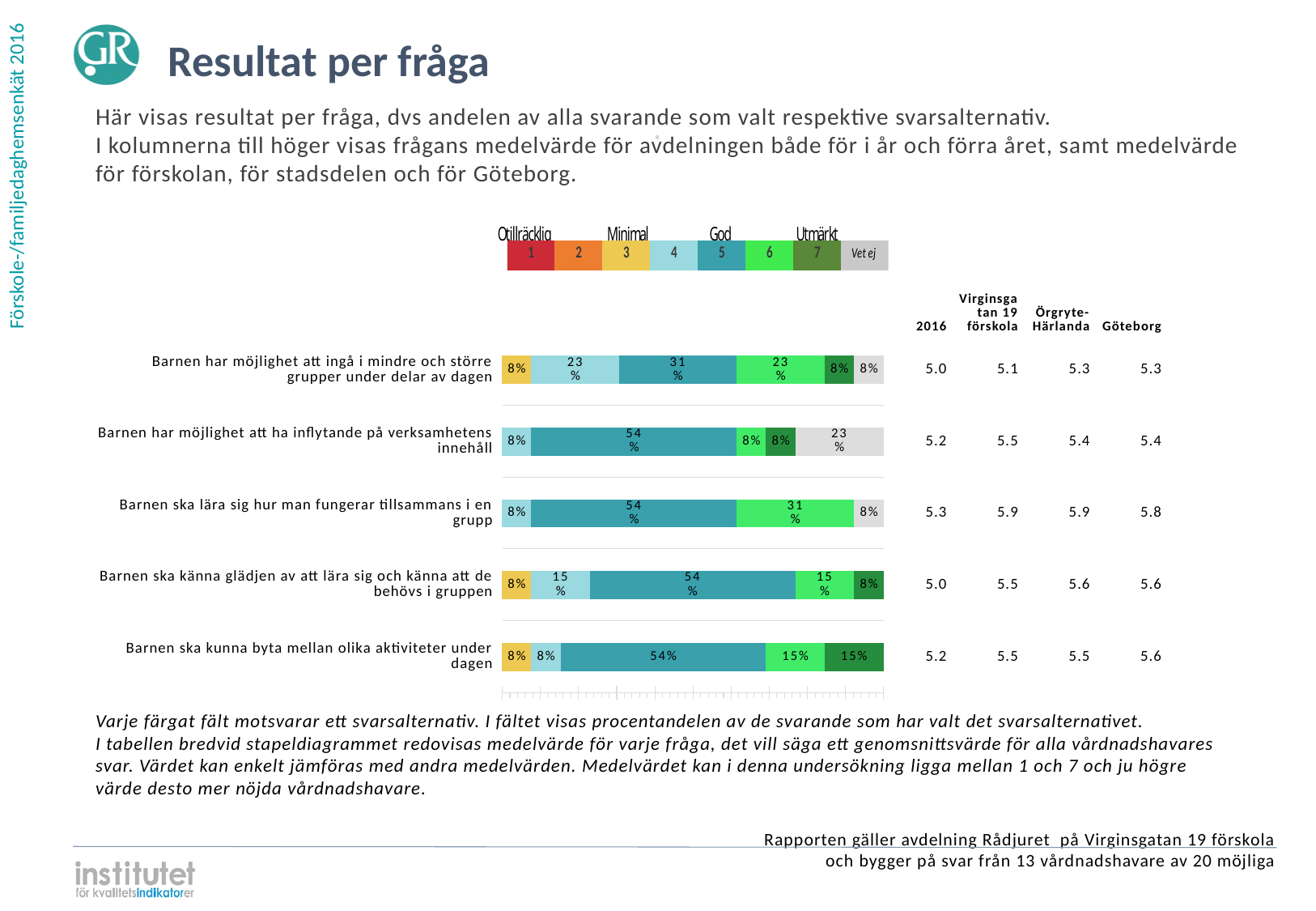
What kind of chart is shown on the slide? Stacked bar chart Which question has the highest 2016 mean value? Barnen ska lära sig hur man fungerar tillsammans i en grupp What percentage chose 'Vet ej' for 'Barnen har möjlighet att ha inflytande på verksamhetens innehåll'? 23% For 'Barnen ska kunna byta mellan olika aktiviteter under dagen', which is larger: the share for answer 5 or the share for answer 7? Answer 5 What percentage of respondents chose answer 5 (teal) for 'Barnen ska kunna byta mellan olika aktiviteter under dagen'? 54% How many answer categories does the legend above the chart list? 8 How many questions (bars) are shown in the chart? 5 What percentage chose answer 6 (light green) for 'Barnen ska lära sig hur man fungerar tillsammans i en grupp'? 31% What label does the legend give to the answer values 1 and 2? Otillräcklig What is the 2016 mean value for 'Barnen ska lära sig hur man fungerar tillsammans i en grupp'? 5.3 What is the Göteborg mean value for 'Barnen har möjlighet att ingå i mindre och större grupper under delar av dagen'? 5.3 What is the difference between the Virginsgatan 19 förskola mean and the 2016 mean for 'Barnen ska lära sig hur man fungerar tillsammans i en grupp'? 0.6